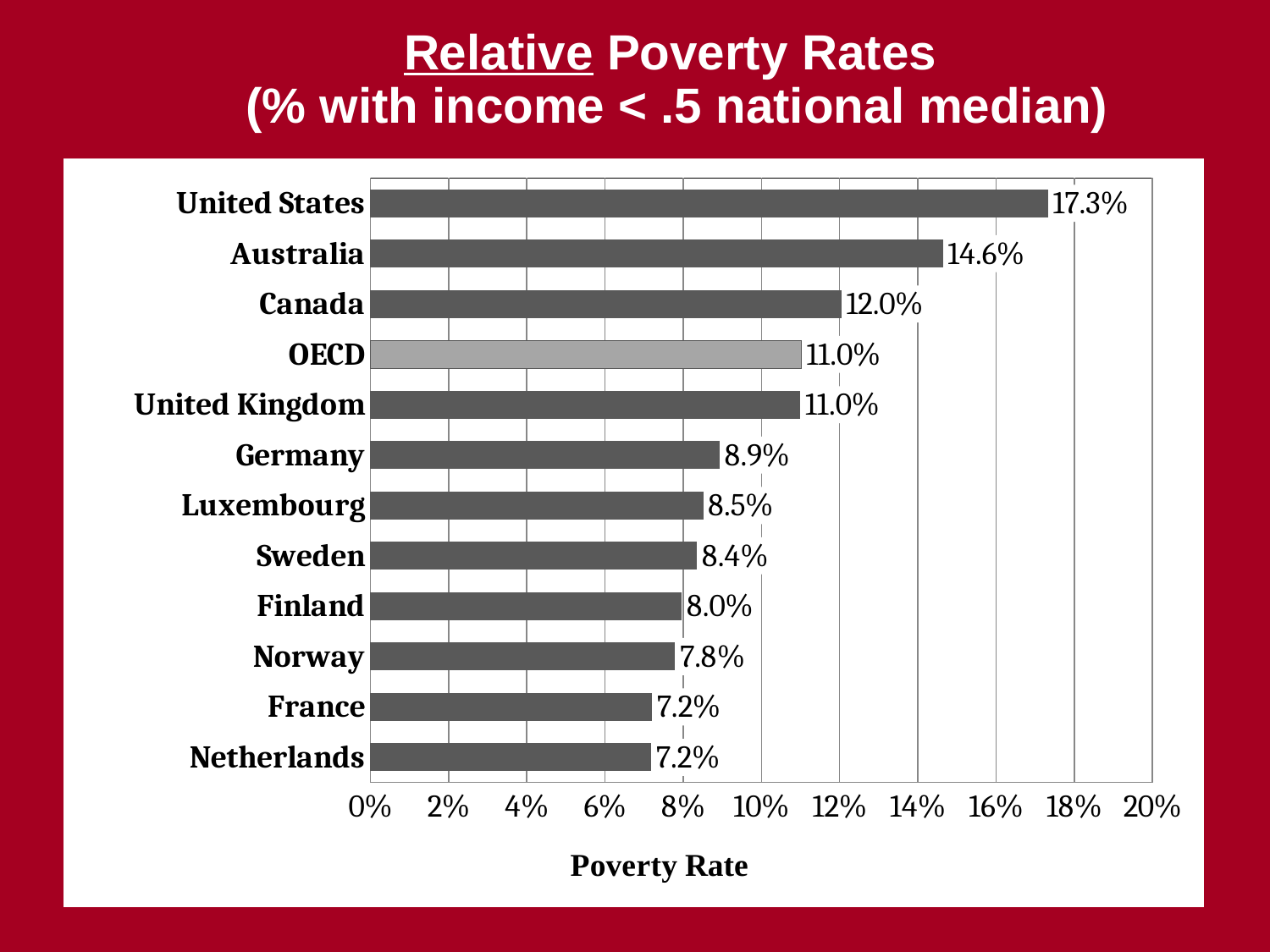
What kind of chart is shown on the slide? Bar chart Which has a higher relative poverty rate, Canada or Germany? Canada Is the value for Australia greater or less than 14%? greater Which has a higher relative poverty rate, Sweden or Finland? Sweden How many countries or groups are shown in the chart? 12 What is the difference between the poverty rates of Canada and the United Kingdom? 1.0% What is the label on the horizontal axis of the chart? Poverty Rate What is the difference between the poverty rates of the United States and Australia? 2.7% What is the relative poverty rate for the United States? 17.3% Which country has the highest relative poverty rate? United States What is the relative poverty rate for Germany? 8.9% What is the relative poverty rate for the OECD? 11.0%